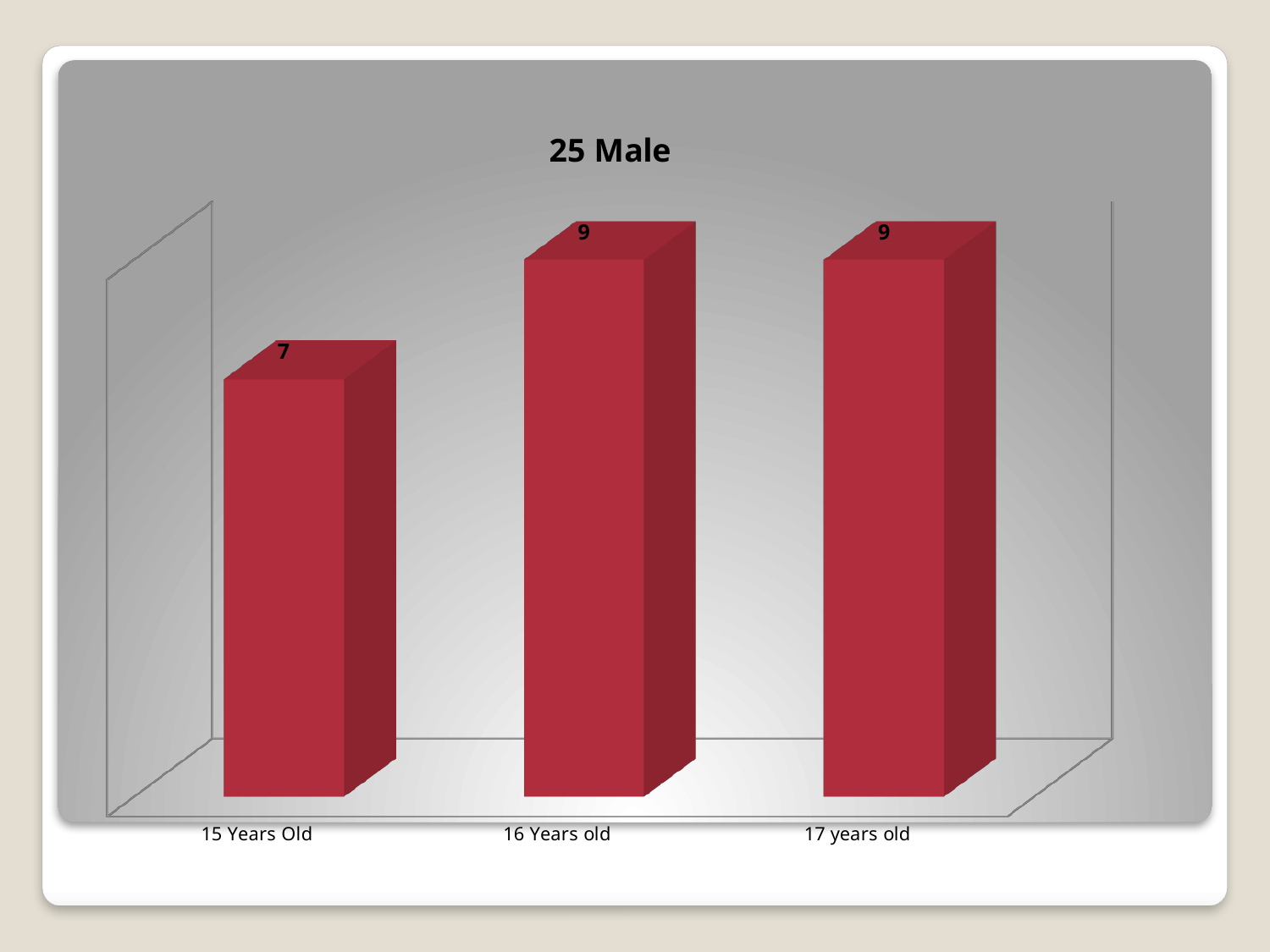
What is the value for 15 Years Old? 7 How many categories are shown on the chart? 3 Which category has the lowest value? 15 Years Old What is the title of the chart? 25 Male What is the value for 16 Years old? 9 What kind of chart is shown on the slide? bar chart What is the difference between the values for 16 Years old and 15 Years Old? 2 Which is larger, the value for 15 Years Old or the value for 17 years old? 17 years old What is the value for 17 years old? 9 Do the values for 16 Years old and 17 years old differ? No, both are 9 What colour are the bars on the chart? red What is the total of the values for all three categories? 25